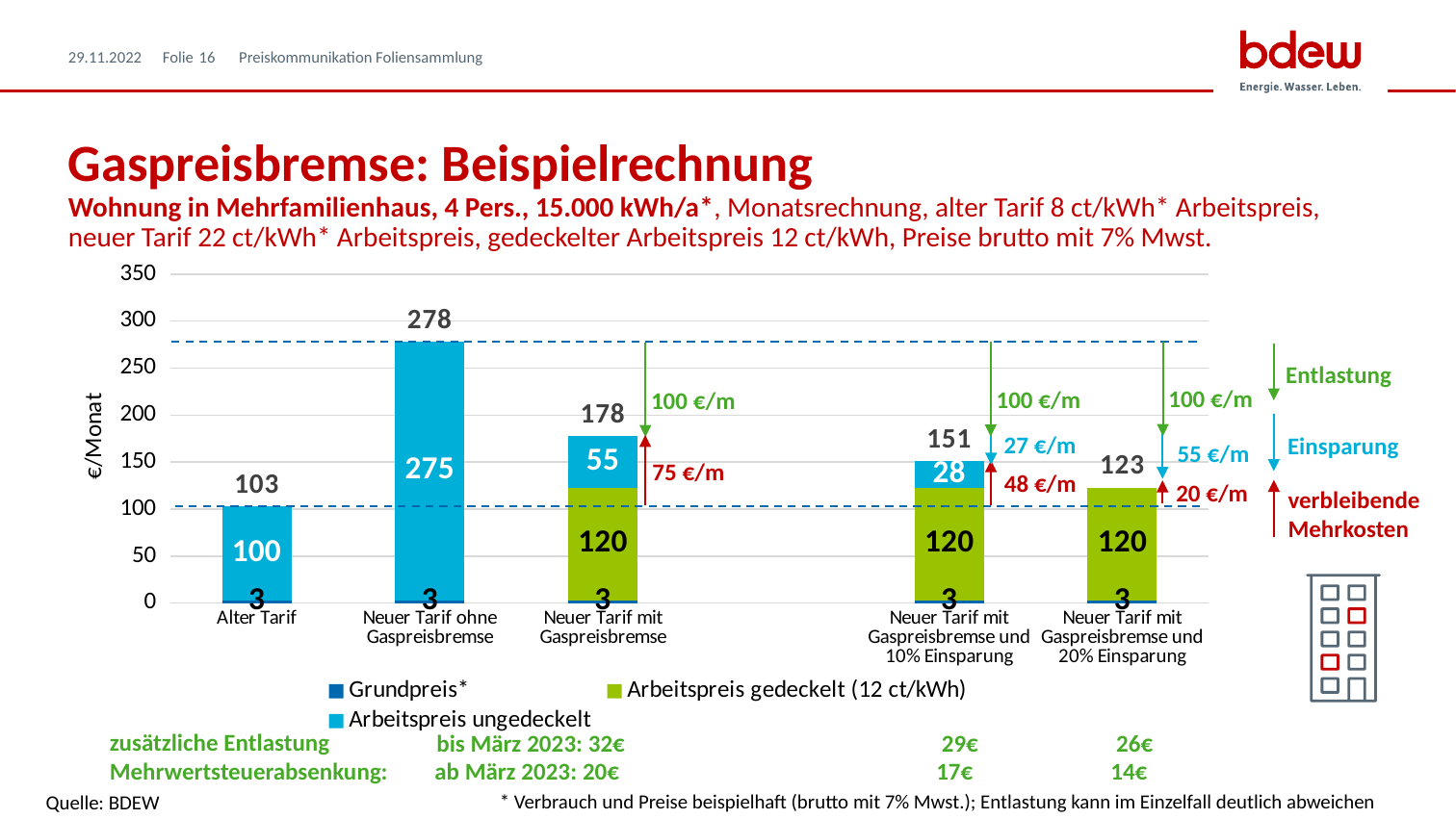
What is the total value shown above the bar for "Neuer Tarif ohne Gaspreisbremse"? 278 Which category has the lowest total? Alter Tarif What is the value of the "Grundpreis*" segment for "Neuer Tarif mit Gaspreisbremse und 20% Einsparung"? 3 What is the label of the y axis? €/Monat What is the value of the "Arbeitspreis gedeckelt (12 ct/kWh)" segment for "Neuer Tarif mit Gaspreisbremse"? 120 What is the value of the "Arbeitspreis ungedeckelt" segment for "Alter Tarif"? 100 What is the difference between the totals for "Neuer Tarif ohne Gaspreisbremse" and "Neuer Tarif mit Gaspreisbremse"? 100 How many series does the legend list? 3 Which category has the highest total? Neuer Tarif ohne Gaspreisbremse What kind of chart is shown on the slide? Stacked bar chart Which has a larger total: "Neuer Tarif mit Gaspreisbremse und 10% Einsparung" or "Neuer Tarif mit Gaspreisbremse und 20% Einsparung"? Neuer Tarif mit Gaspreisbremse und 10% Einsparung How many categories are shown on the x axis? 5